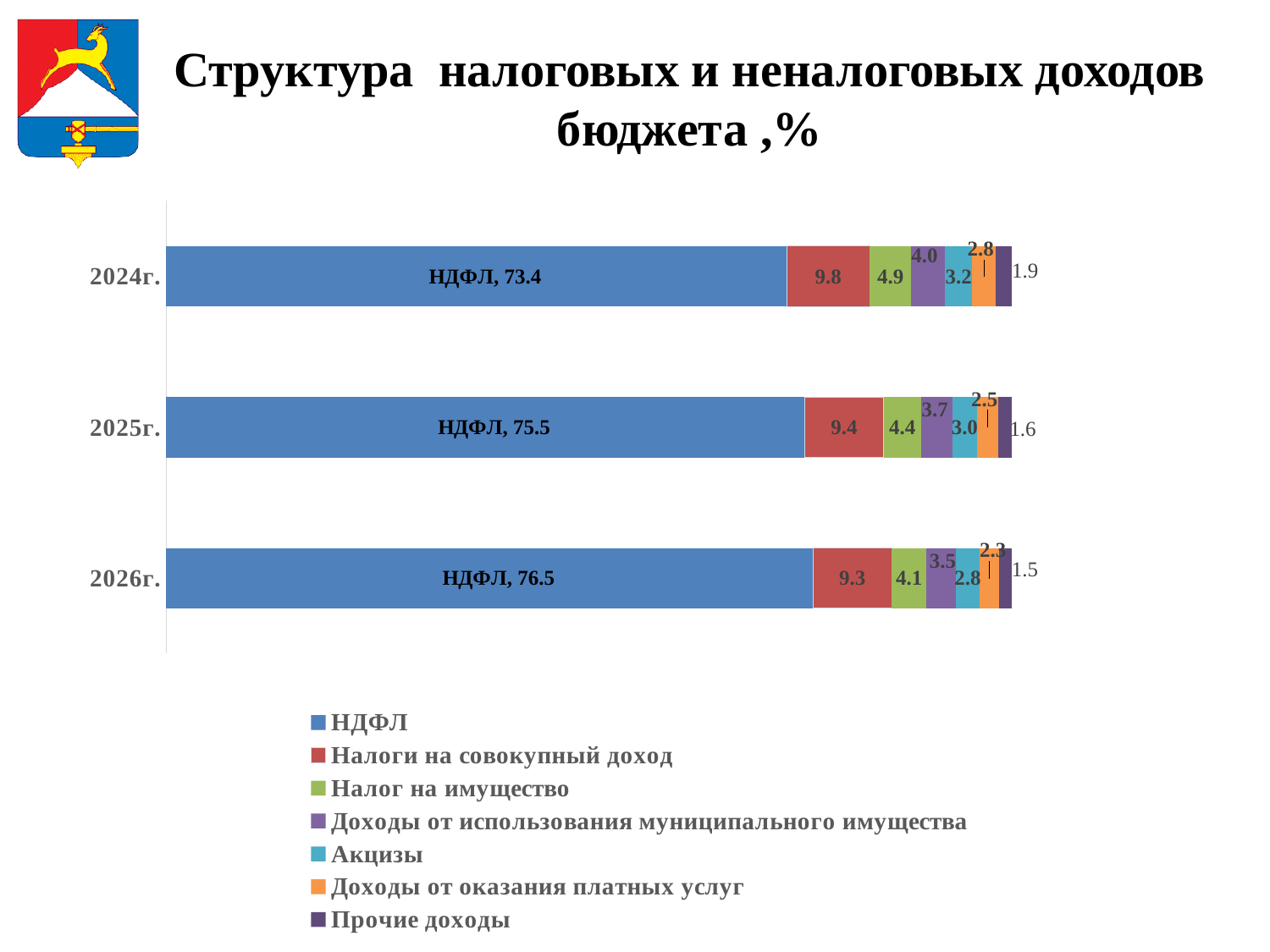
Does НДФЛ rise or fall from 2024г. to 2026г.? Rises What is the value of НДФЛ for 2024г.? 73.4 What is the value of Акцизы for 2024г.? 3.2 What is the value of Прочие доходы for 2026г.? 1.5 What is the value of Налоги на совокупный доход for 2025г.? 9.4 How many categories (years) are plotted on the chart? 3 In which year is the НДФЛ share the highest? 2026г. What kind of chart is shown on the slide? Stacked bar chart What is the value of НДФЛ for 2026г.? 76.5 What is the difference between the НДФЛ value for 2026г. and for 2024г.? 3.1 In which year is the Налог на имущество share the lowest? 2026г. How many series does the legend list? 7